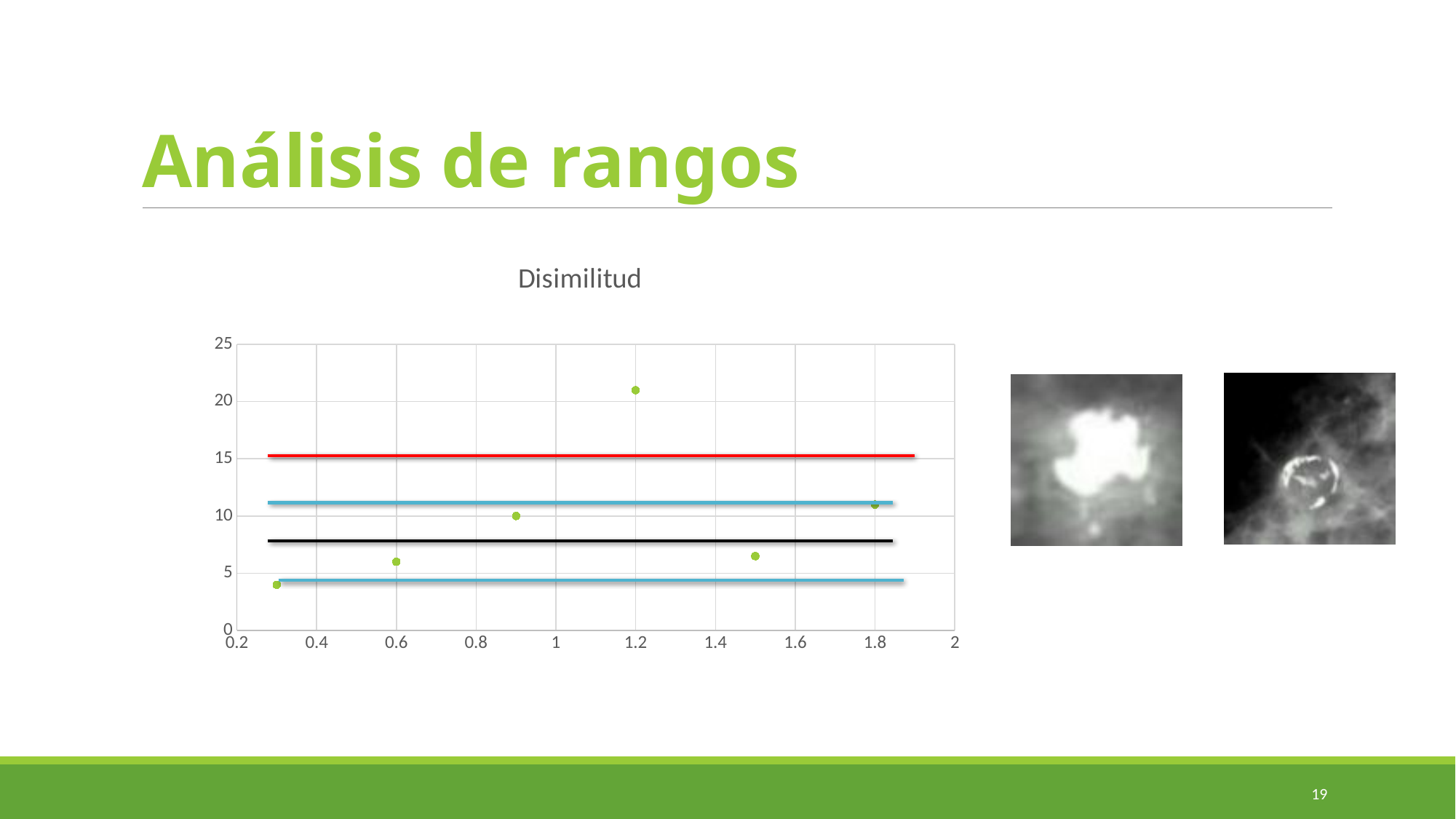
Which green point has the larger value, the one at x = 1.2 or the one at x = 1.5? x = 1.2 Is the value of the green point at x = 1.8 greater or less than 10? greater What colour is the topmost horizontal line in the chart? red What kind of chart is shown on the slide? scatter chart How many green data points are plotted in the chart? 6 At which x value does the lowest green data point occur? 0.3 Is the value of the green point at x = 0.3 greater or less than 5? less What is the title of the chart? Disimilitud At which x value does the highest green data point occur? 1.2 Which green point has the larger value, the one at x = 0.6 or the one at x = 0.9? x = 0.9 Is the value of the green point at x = 1.2 greater or less than 20? greater